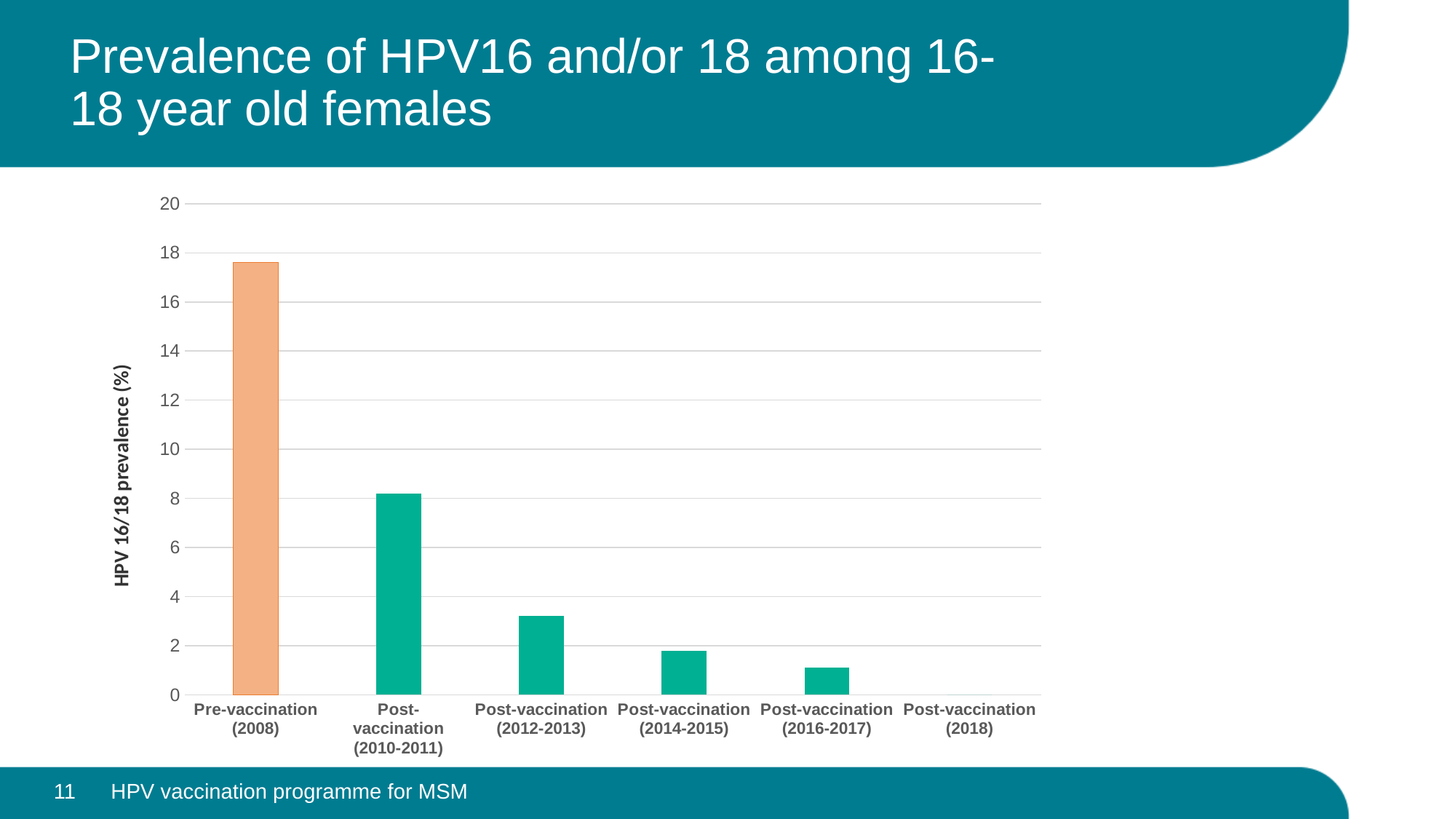
Is the value for Post-vaccination (2010-2011) greater or less than 10? less Which category has the highest HPV 16/18 prevalence? Pre-vaccination (2008) Is the value for Post-vaccination (2012-2013) greater or less than 2? greater Which bar is coloured differently (orange) from the others? Pre-vaccination (2008) What kind of chart is shown on the slide? bar chart Is the value for Post-vaccination (2016-2017) greater or less than 2? less What is the label of the y axis? HPV 16/18 prevalence (%) How many categories are plotted on the x axis? 6 Which is larger, the value for Post-vaccination (2010-2011) or Post-vaccination (2014-2015)? Post-vaccination (2010-2011) Do the values rise or fall from left to right along the x axis? fall Which category has the lowest HPV 16/18 prevalence? Post-vaccination (2018)